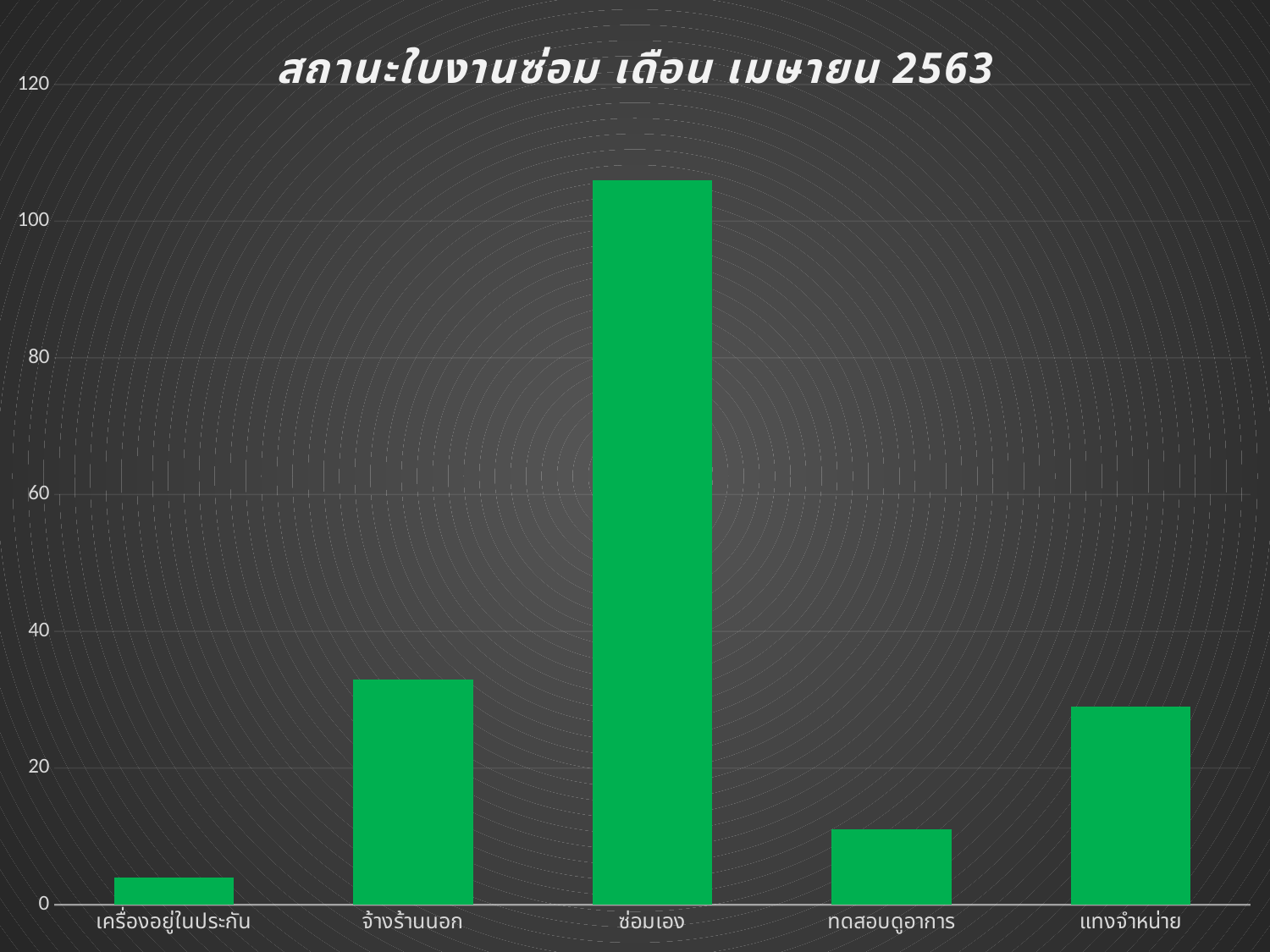
How many categories are shown on the x axis? 5 What kind of chart is shown on the slide? Bar chart Which category has the highest bar? ซ่อมเอง Is the value for ซ่อมเอง greater or less than 100? greater Which category has the lowest bar? เครื่องอยู่ในประกัน Which is larger, the value for แทงจำหน่าย or the value for เครื่องอยู่ในประกัน? แทงจำหน่าย Is the value for ทดสอบดูอาการ greater or less than 20? less What is the title of the chart? สถานะใบงานซ่อม เดือน เมษายน 2563 Is the value for จ้างร้านนอก greater or less than 40? less Which is larger, the value for จ้างร้านนอก or the value for ทดสอบดูอาการ? จ้างร้านนอก